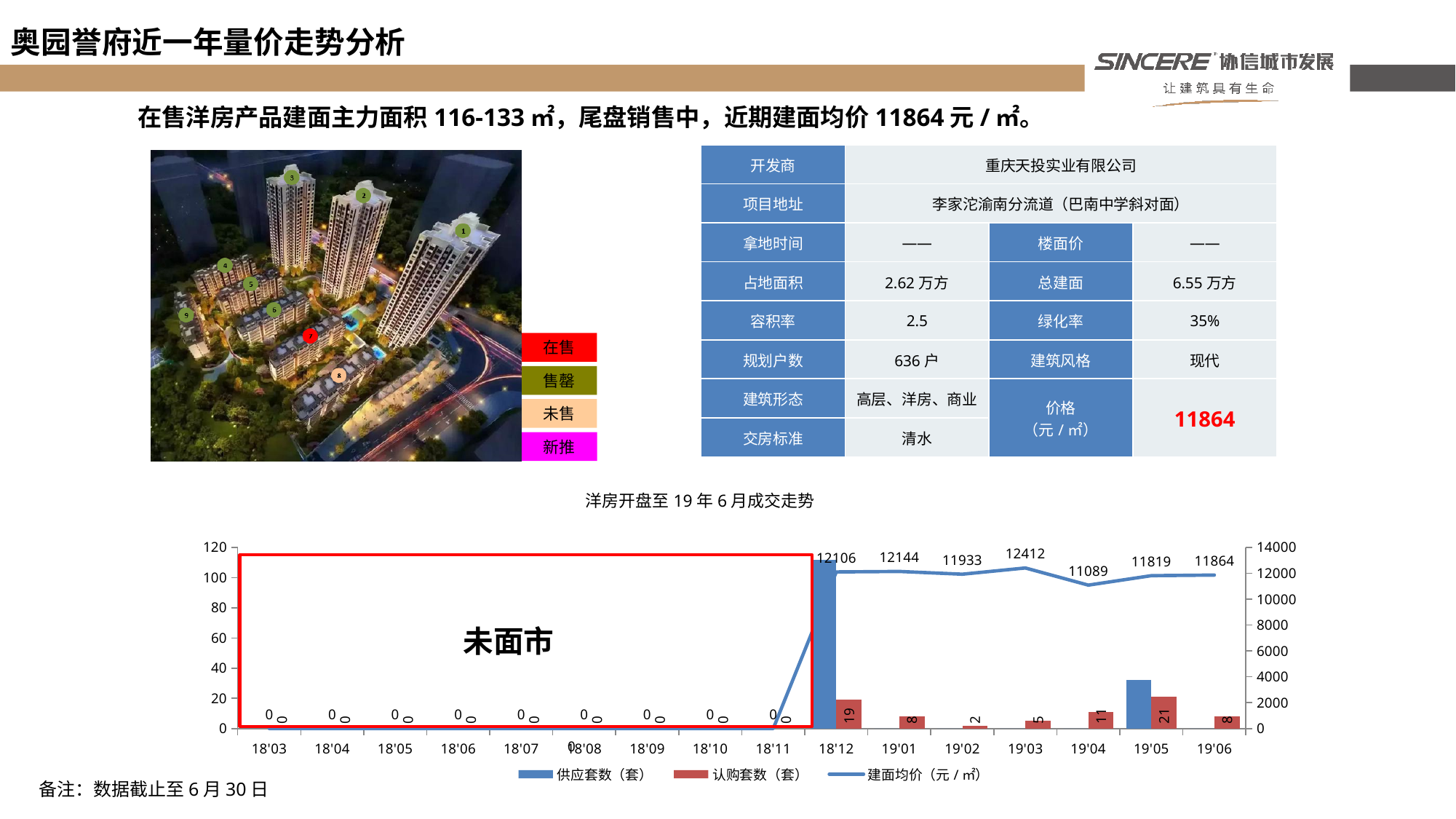
Which month has the highest 认购套数? 19'05 Is the 供应套数 value for 19'05 greater or less than 20? greater How many months are shown on the x axis of the chart? 16 Which is larger, the 认购套数 for 18'12 or for 19'04? 18'12 What is the 建面均价 value for 18'12? 12106 In which month is the 建面均价 line at its highest? 19'03 What is the title of the chart? 洋房开盘至19年6月成交走势 What is the 建面均价 value for 19'03? 12412 How many series does the chart legend list? 3 What is the difference between the 建面均价 for 19'03 and 19'04? 1323 What is the 认购套数 value for 19'05? 21